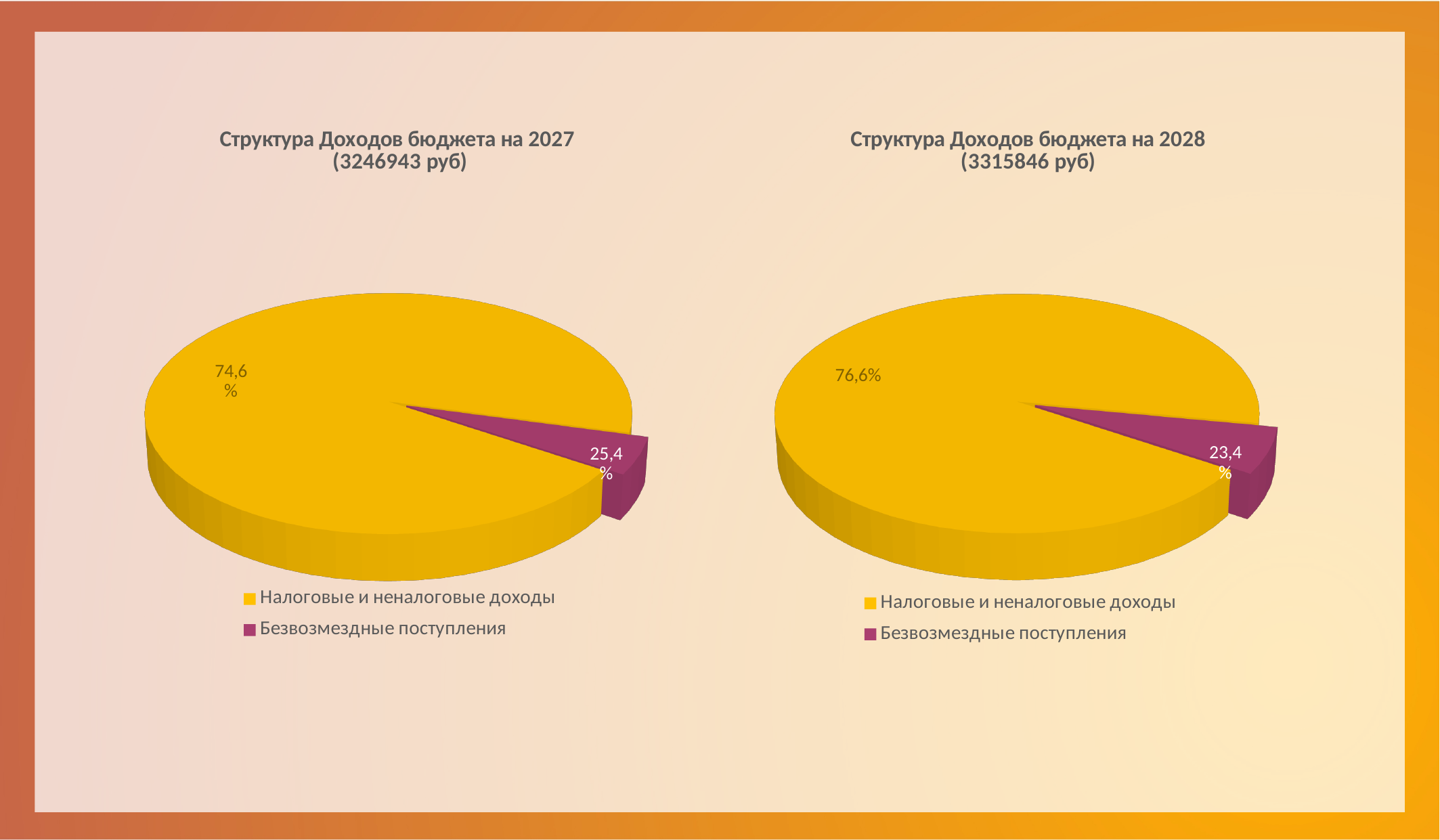
In the right chart (2028), which category has the smallest slice? Безвозмездные поступления In the left chart (2027), which category has the largest slice? Налоговые и неналоговые доходы In the chart titled 'Структура Доходов бюджета на 2028', what share does 'Налоговые и неналоговые доходы' have? 76,6% In the chart titled 'Структура Доходов бюджета на 2028', what share does 'Безвозмездные поступления' have? 23,4% In the chart titled 'Структура Доходов бюджета на 2027', what share does 'Безвозмездные поступления' have? 25,4% Is the share of 'Безвозмездные поступления' larger in the 2027 chart or in the 2028 chart? 2027 What kind of chart is the chart titled 'Структура Доходов бюджета на 2028'? Pie chart What total amount in rubles is given in the title of the right chart (2028)? 3315846 руб In the right chart (2028), what is the difference in percentage points between 'Налоговые и неналоговые доходы' and 'Безвозмездные поступления'? 53,2 How many categories does the legend of the left chart (2027) list? 2 In the left chart (2027), what is the difference in percentage points between 'Налоговые и неналоговые доходы' and 'Безвозмездные поступления'? 49,2